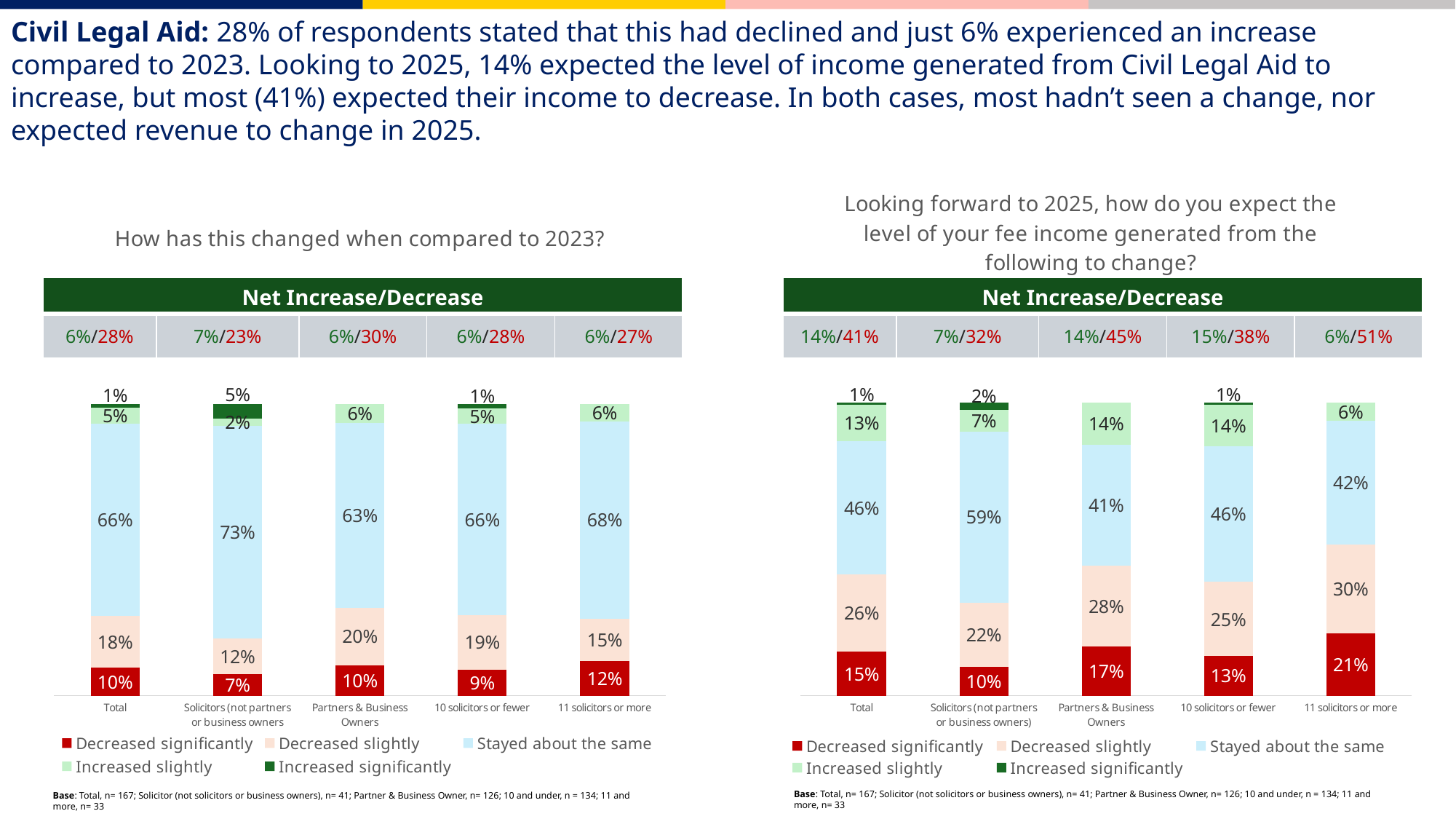
In the right chart (Looking forward to 2025), what percentage of the 11 solicitors or more group expect income to decrease significantly? 21% In the left chart (compared to 2023), what is the Net Increase/Decrease shown for Solicitors (not partners or business owners)? 7%/23% In the right chart (Looking forward to 2025), what is the Net Increase/Decrease shown for 11 solicitors or more? 6%/51% In the right chart (Looking forward to 2025), what is the difference between the 'Decreased slightly' values for 11 solicitors or more and Solicitors (not partners or business owners)? 8% How many series does the legend of the left chart (compared to 2023) list? 5 In the left chart (compared to 2023), which is larger: the 'Decreased slightly' value for Partners & Business Owners or for 11 solicitors or more? Partners & Business Owners In the right chart (Looking forward to 2025), which category has the lowest 'Increased slightly' value? 11 solicitors or more In the left chart (How has this changed when compared to 2023?), what percentage of the Total group said income stayed about the same? 66% What type of chart is used in the left chart (How has this changed when compared to 2023?)? Stacked bar chart In the left chart (compared to 2023), which category has the highest 'Stayed about the same' value? Solicitors (not partners or business owners) How many categories are shown on the x axis of the right chart (Looking forward to 2025)? 5 In the right chart (Looking forward to 2025), what is the combined 'Decreased significantly' and 'Decreased slightly' share for Partners & Business Owners? 45%